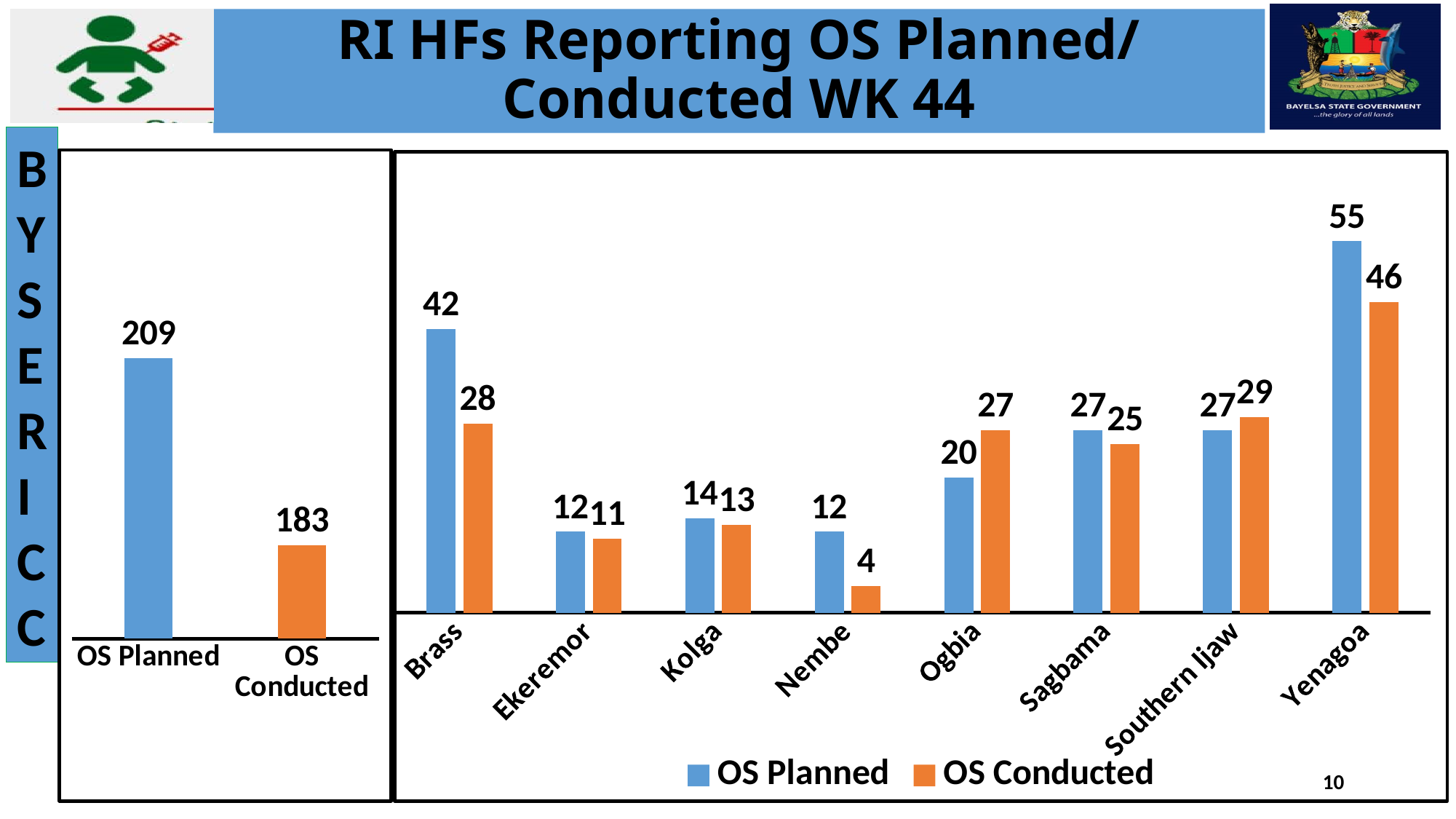
What type of chart is the right chart? Bar chart In the right chart, what is the difference between OS Planned and OS Conducted for Brass? 14 In the right chart, which is larger for Southern Ijaw: OS Planned or OS Conducted? OS Conducted In the left chart, what is the difference between OS Planned and OS Conducted? 26 In the left chart, what is the value for OS Planned? 209 In the right chart, which LGA has the lowest OS Conducted value? Nembe In the right chart, what is the OS Conducted value for Nembe? 4 How many LGAs are shown on the x axis of the right chart? 8 How many series does the legend of the right chart list? 2 In the right chart, which LGA has the highest OS Conducted value? Yenagoa In the left chart, what is the value for OS Conducted? 183 In the right chart, what is the OS Planned value for Yenagoa? 55